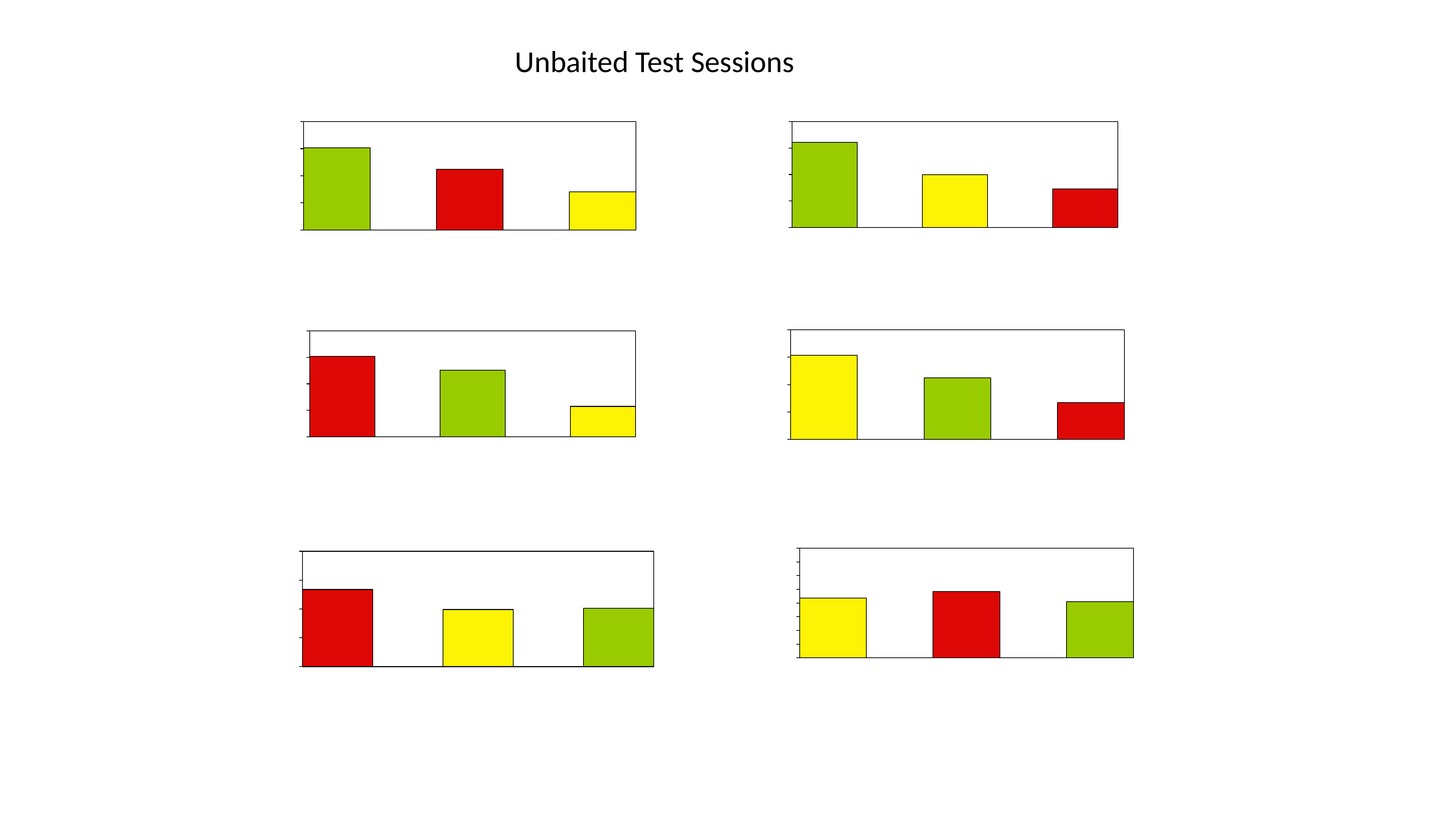
In the middle-right chart, which coloured bar is the tallest? yellow In the middle-right chart, which coloured bar is the shortest? red In the top-right chart, which coloured bar is the shortest? red What is the title shown above the charts on the slide? Unbaited Test Sessions How many bars does the top-left chart show? 3 In the bottom-left chart, which coloured bar is the tallest? red In the middle-left chart, is the green bar or the yellow bar taller? green In the middle-left chart, which coloured bar is the tallest? red What kind of chart is the top-left chart on the slide? bar chart In the top-left chart, which coloured bar is the shortest? yellow